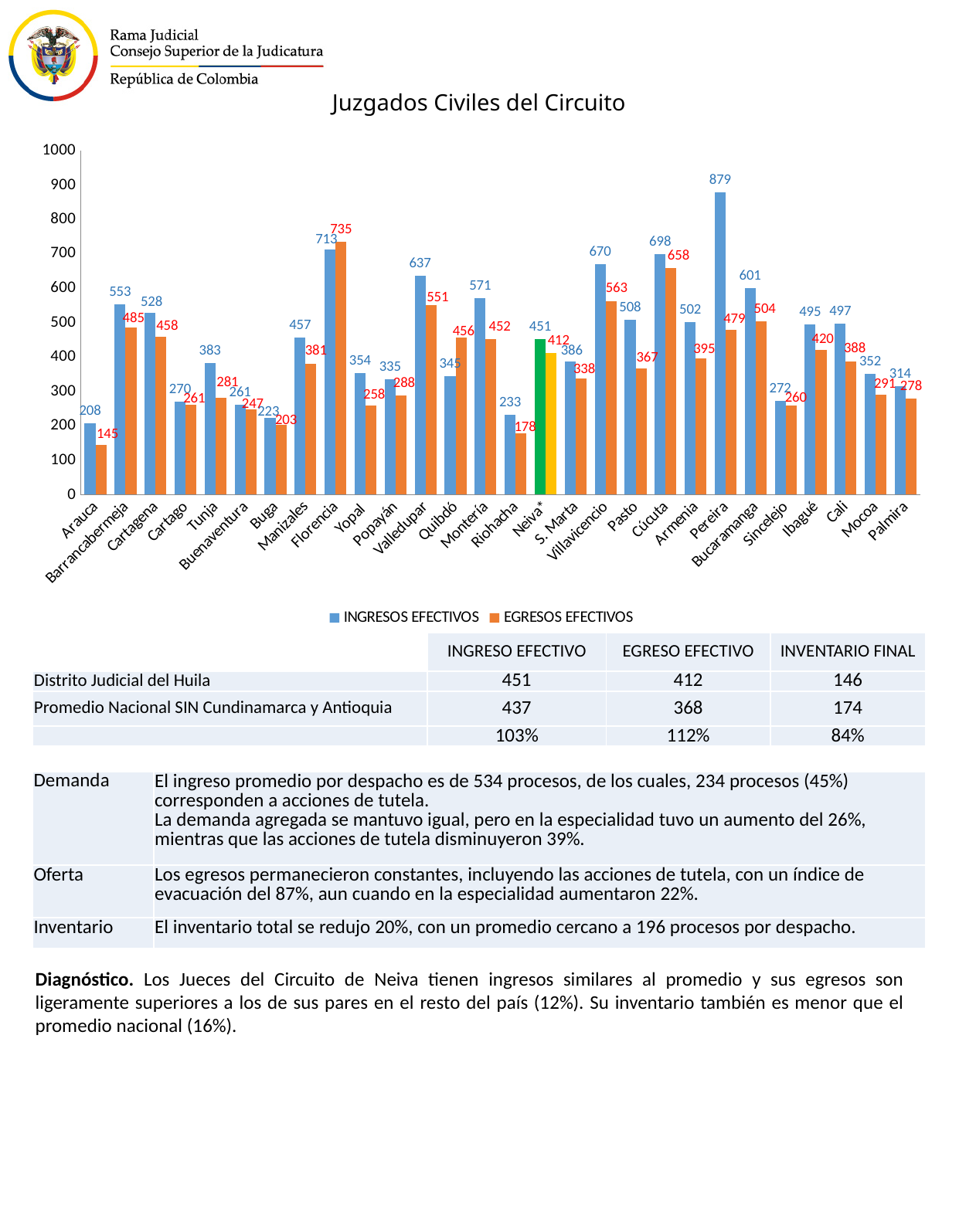
What is the INGRESOS EFECTIVOS value for Valledupar? 637 Which is larger for Quibdó: INGRESOS EFECTIVOS or EGRESOS EFECTIVOS? EGRESOS EFECTIVOS Is the INGRESOS EFECTIVOS value for Cúcuta greater or less than 600? greater What kind of chart is shown on the slide? Bar chart Which category has the highest INGRESOS EFECTIVOS value? Pereira What is the EGRESOS EFECTIVOS value for Neiva*? 412 How many series does the legend list? 2 Which category has the lowest EGRESOS EFECTIVOS value? Arauca What is the INGRESOS EFECTIVOS value for Pereira? 879 What is the difference between INGRESOS EFECTIVOS and EGRESOS EFECTIVOS for Pereira? 400 How many categories are shown on the x axis of the chart? 28 Which category has the highest EGRESOS EFECTIVOS value? Florencia